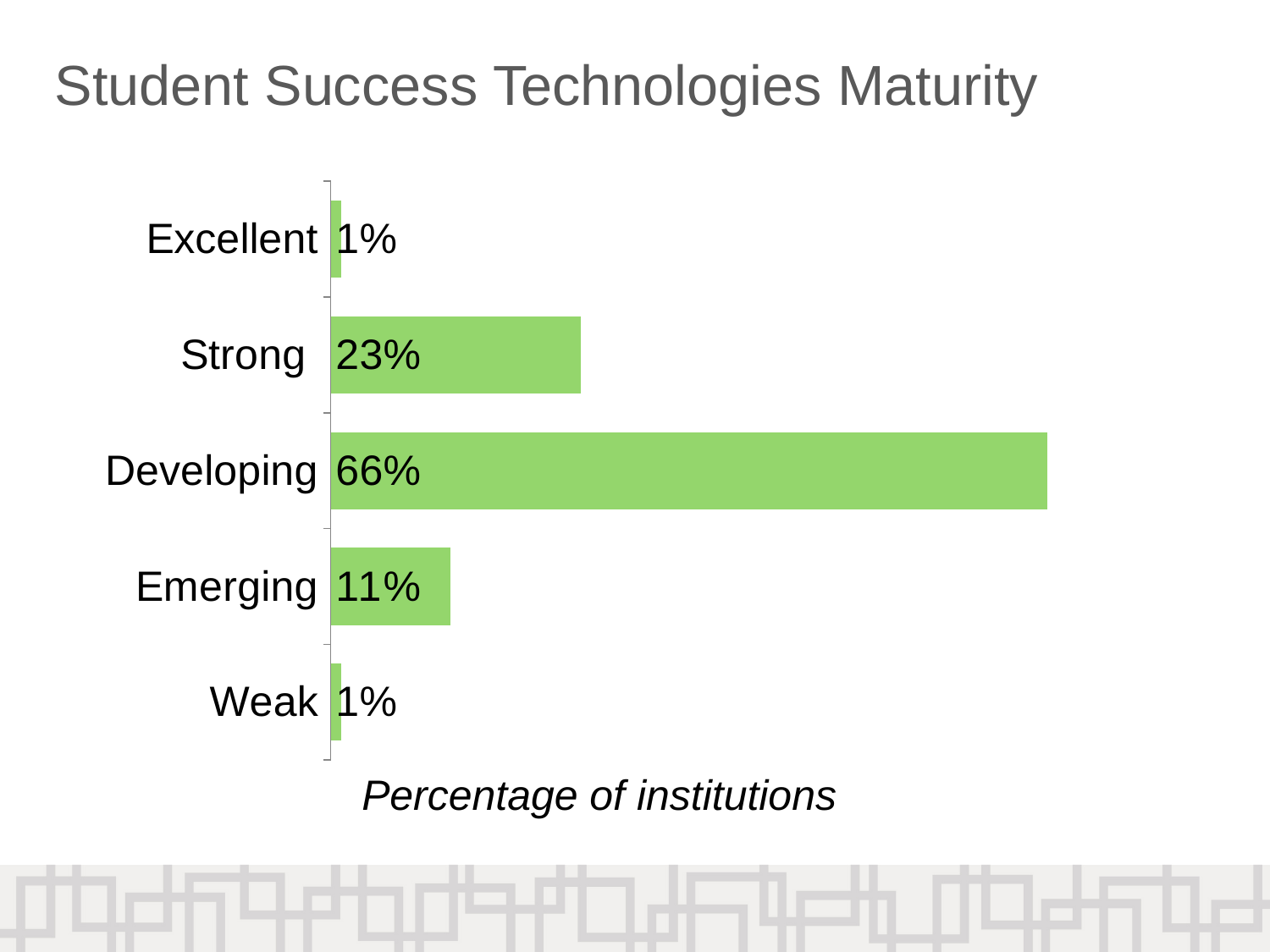
Which maturity category has the highest percentage of institutions? Developing What kind of chart is shown on the slide? Bar chart What percentage of institutions are rated Emerging? 11% What is the label below the chart describing the values? Percentage of institutions What is the title of the chart? Student Success Technologies Maturity How many maturity categories are shown in the chart? 5 What is the difference in percentage points between Developing and Strong? 43 What percentage of institutions are rated Excellent? 1% What percentage of institutions are rated Developing? 66% What percentage of institutions are rated Strong? 23% Which has a larger percentage of institutions, Strong or Emerging? Strong What is the difference in percentage points between Strong and Emerging? 12